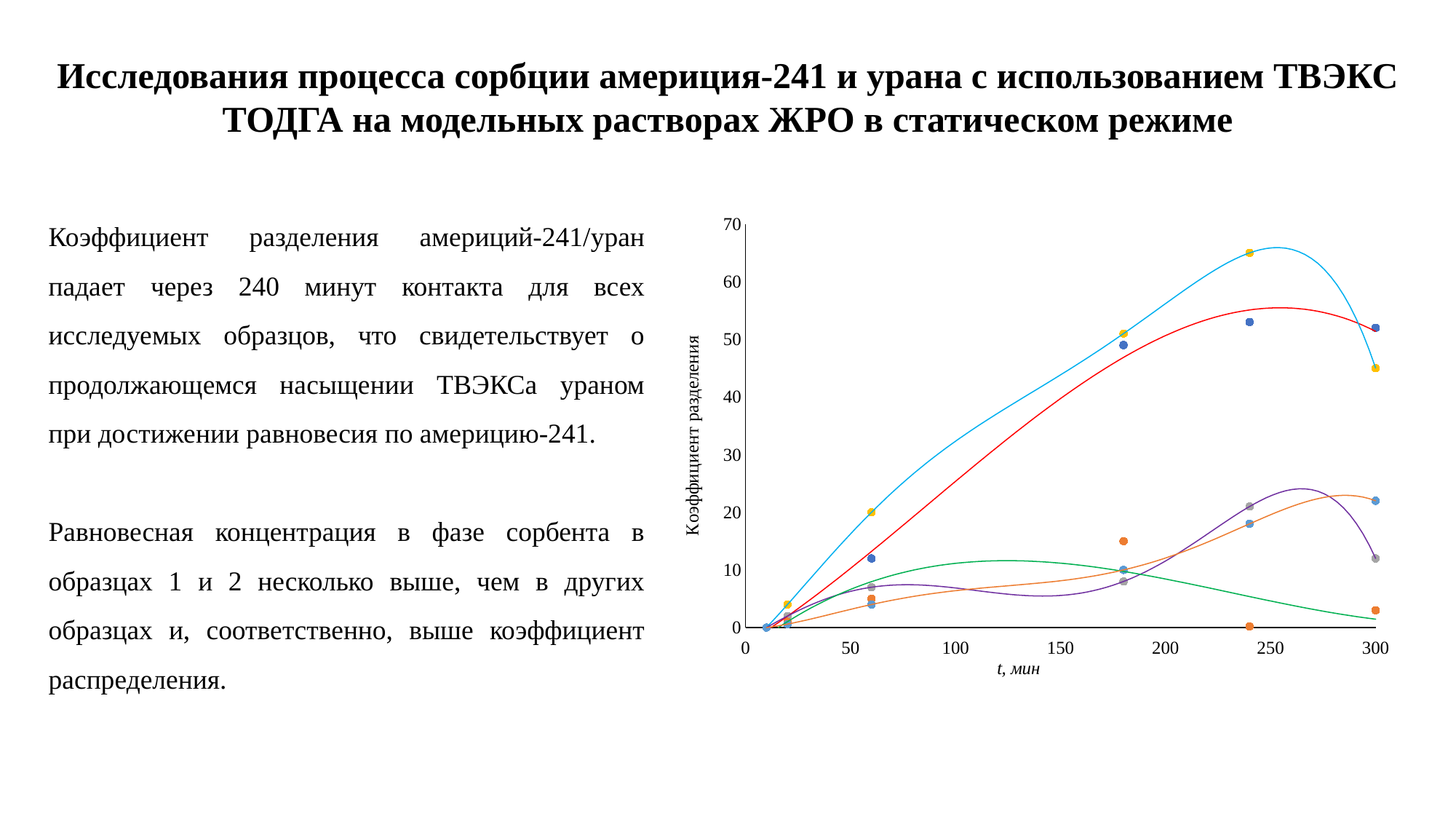
What kind of chart is shown on the slide? Scatter chart with smoothed lines What is the highest tick value shown on the vertical axis? 70 Do the plotted values generally rise or fall between t = 0 and t = 240 minutes? rise At what time on the horizontal axis does the highest plotted point occur? 240 How many tick marks are labelled on the horizontal axis? 7 Is the highest plotted point on the chart greater or less than 60? greater What is the highest tick value shown on the horizontal axis? 300 What is the label of the horizontal axis of the chart? t, мин What is the label of the vertical axis of the chart? Коэффициент разделения Is the highest plotted point on the chart greater or less than 70? less